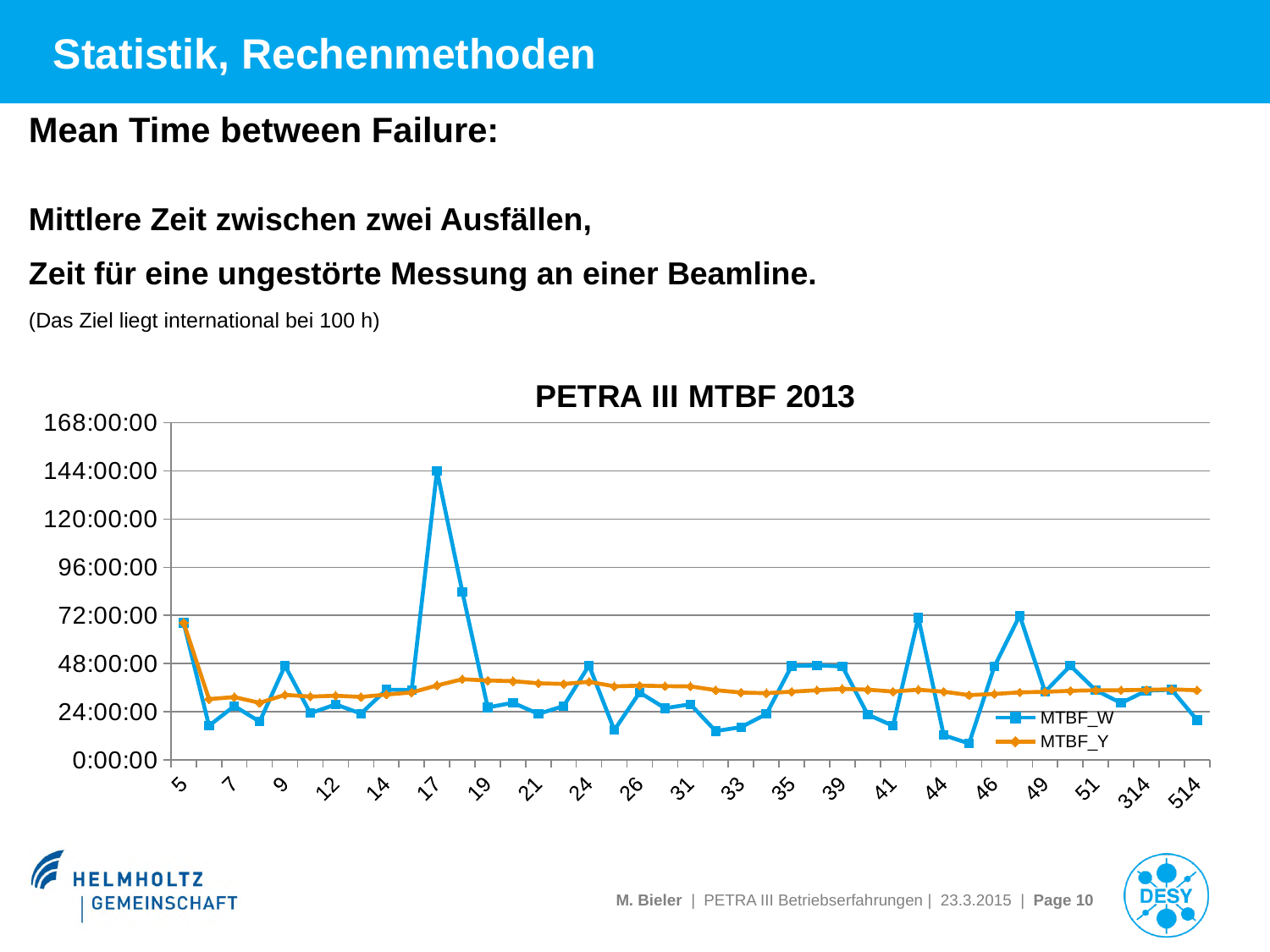
What are the two series names shown in the chart legend? MTBF_W and MTBF_Y Is the MTBF_W value at category 5 greater or less than 48:00:00? greater Is the MTBF_Y value at category 19 greater or less than 24:00:00? greater Is the MTBF_Y value at category 5 greater or less than 48:00:00? greater What kind of chart is shown on the slide? line chart At which x-axis category does the MTBF_W series reach its highest value? 17 What is the title of the chart? PETRA III MTBF 2013 At category 17, which series has the higher value, MTBF_W or MTBF_Y? MTBF_W How many series does the legend of the chart list? 2 At category 44, which series has the higher value, MTBF_W or MTBF_Y? MTBF_Y